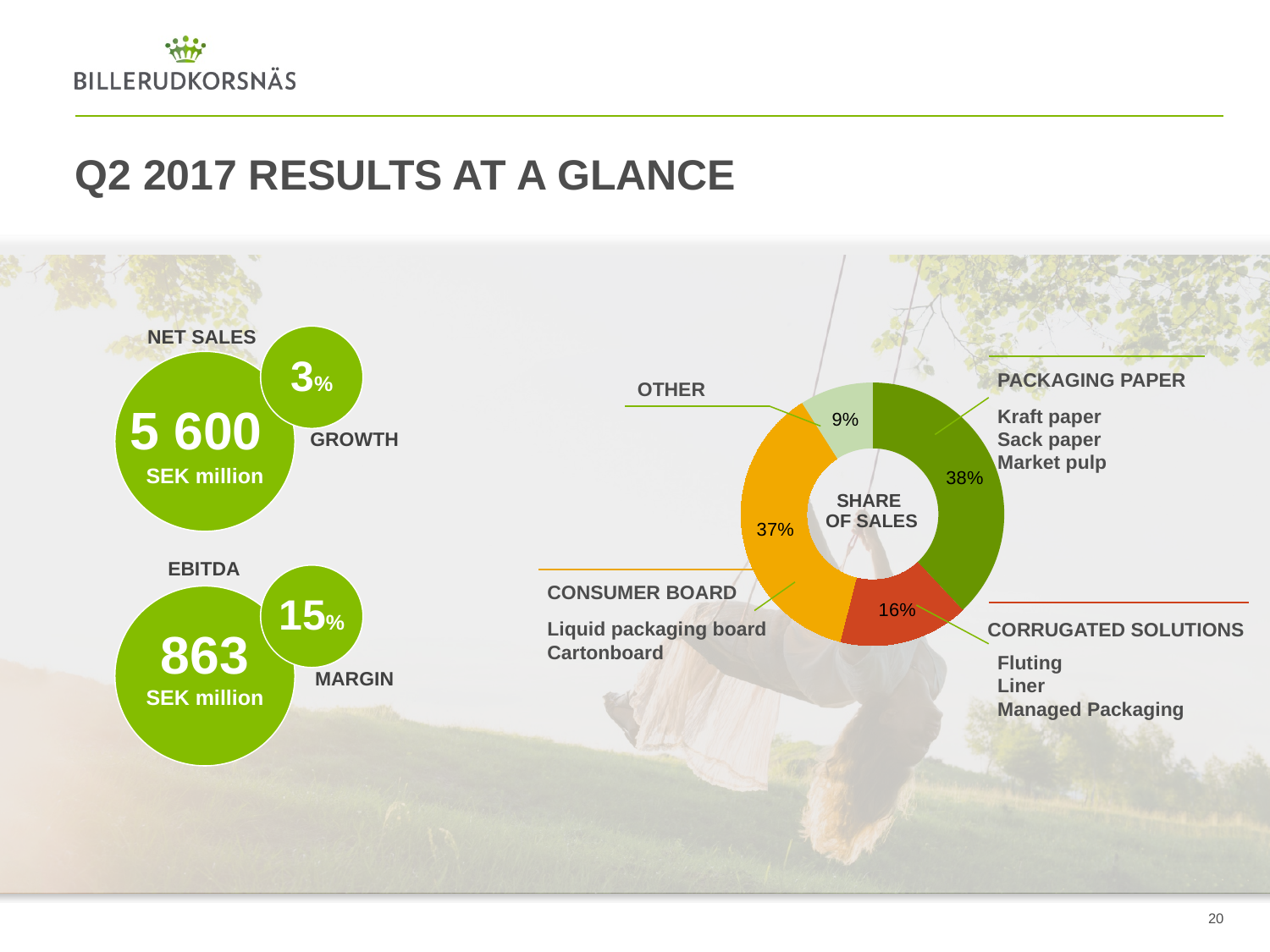
In the Share of Sales chart, which has the larger share: Corrugated Solutions or Other? Corrugated Solutions How many segments are shown in the Share of Sales chart? 4 In the Share of Sales chart, what is the combined share of Packaging Paper and Consumer Board? 75% Which segment has the smallest share in the Share of Sales chart? Other In the Share of Sales chart, how many percentage points larger is Consumer Board's share than Corrugated Solutions' share? 21 percentage points What share of sales does Corrugated Solutions account for in the Share of Sales chart? 16% What type of chart is used to show the share of sales? Donut (pie) chart What share of sales does the Other segment account for in the Share of Sales chart? 9% Which segment has the largest share in the Share of Sales chart? Packaging Paper What share of sales does Packaging Paper account for in the Share of Sales chart? 38% What share of sales does Consumer Board account for in the Share of Sales chart? 37% What colour is the Consumer Board segment in the Share of Sales chart? Yellow/orange